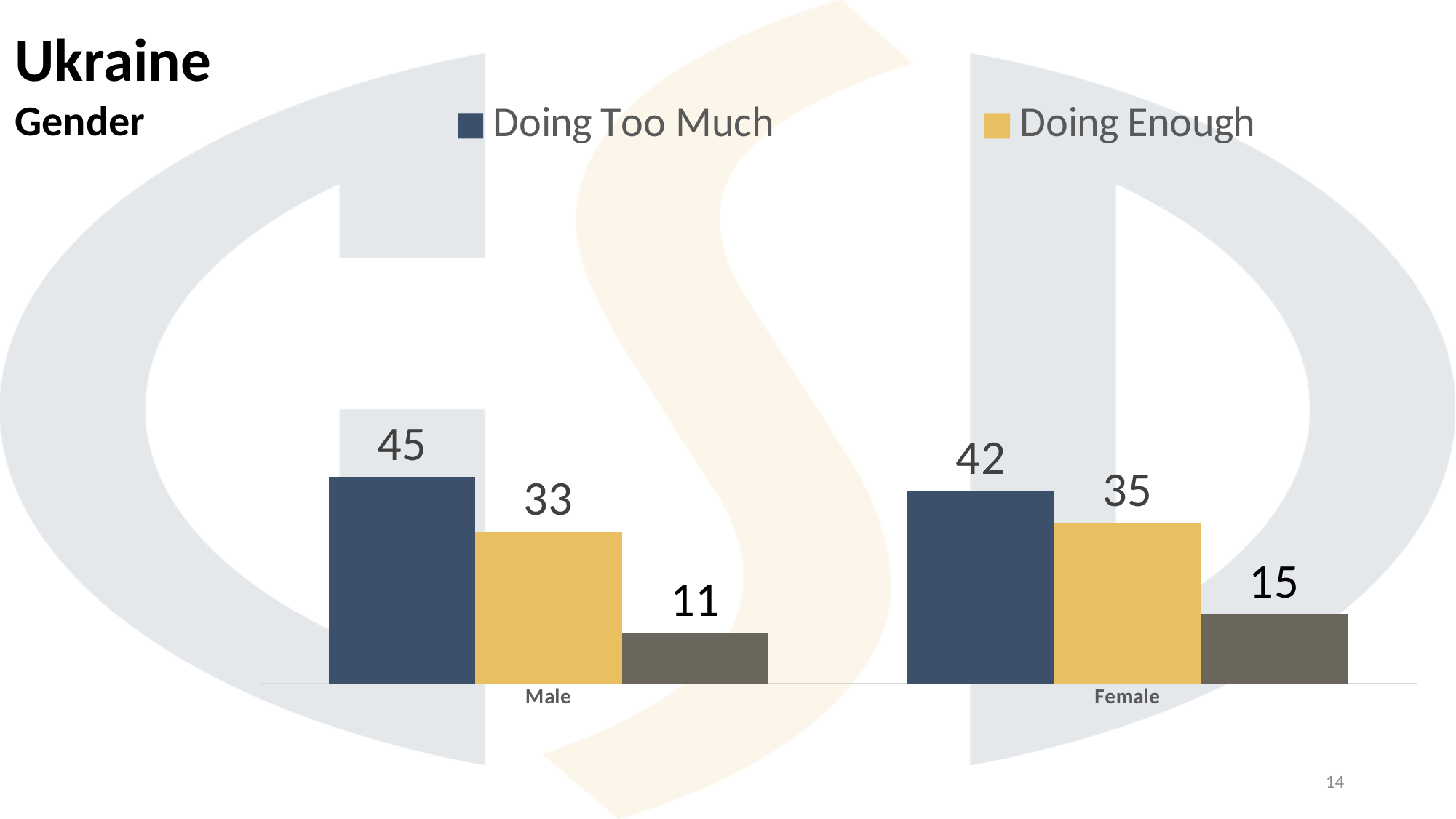
What is the value for Doing Enough for Female? 35 What is the difference between the Doing Too Much values for Male and Female? 3 What is the value for Doing Too Much for Male? 45 What is the value for Doing Too Much for Female? 42 What is the difference between Doing Too Much and Doing Enough for Female? 7 What kind of chart is shown on the slide? Bar chart What is the value for Doing Enough for Male? 33 How many series does the legend list? 2 Which category has the higher value for Doing Too Much, Male or Female? Male How many categories are shown on the x axis? 2 What is the difference between Doing Too Much and Doing Enough for Male? 12 Which category has the higher value for Doing Enough, Male or Female? Female